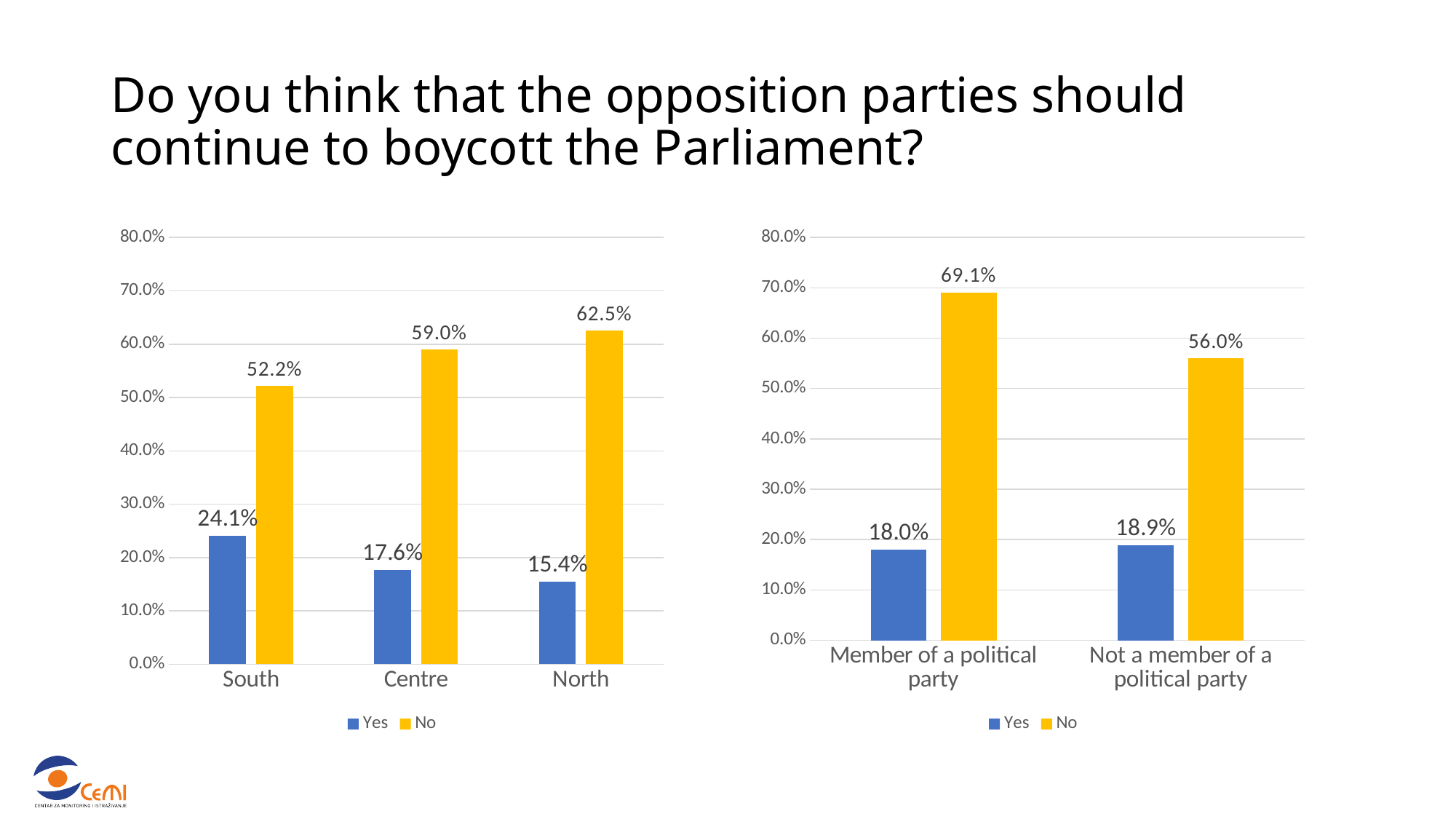
In the left chart (by region), which region has the highest 'Yes' value? South How many series does the legend of the right chart list? 2 In the right chart (by party membership), what is the 'No' value for 'Member of a political party'? 69.1% How many regions are shown on the x axis of the left chart? 3 In the right chart (by party membership), what is the 'Yes' value for 'Not a member of a political party'? 18.9% In the left chart (by region), which region has the lowest 'No' value? South In the left chart (by region), what is the 'No' value for North? 62.5% In the right chart (by party membership), what is the difference between the 'No' values for members and non-members of a political party? 13.1% In the left chart (by region), what is the 'Yes' value for Centre? 17.6% In the left chart (by region), what is the difference between the 'No' and 'Yes' values for South? 28.1% What kind of chart is the left chart (by region)? Bar chart In the right chart (by party membership), which group has the larger 'No' value? Member of a political party